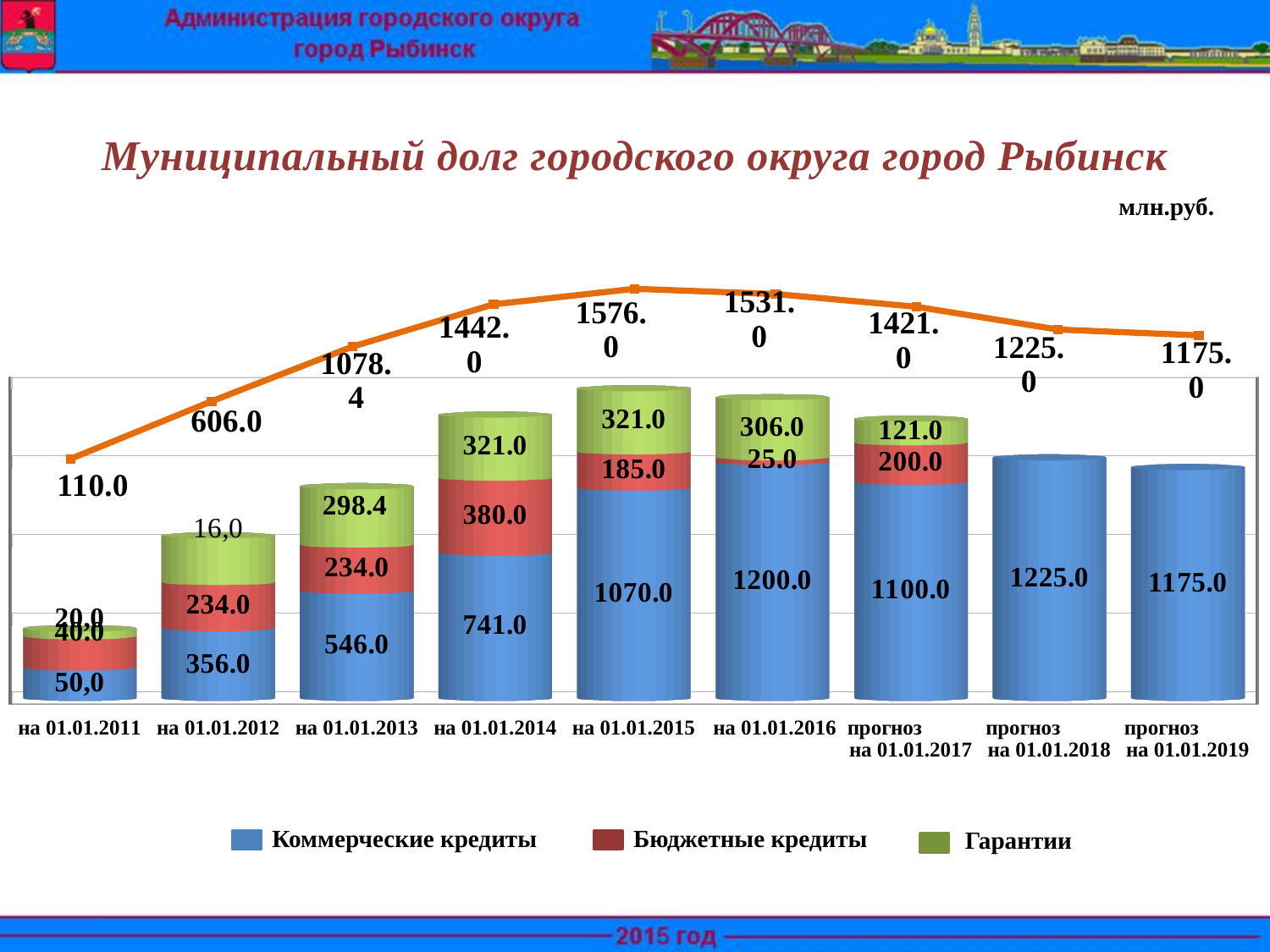
What is the value of Бюджетные кредиты for на 01.01.2015? 185.0 Which is larger: Бюджетные кредиты for на 01.01.2014 or for прогноз на 01.01.2017? на 01.01.2014 At which date is the total municipal debt lowest? на 01.01.2011 At which date is the total municipal debt highest? на 01.01.2015 How many dates (categories) are shown on the x axis? 9 What is the value of Коммерческие кредиты for на 01.01.2014? 741.0 What kind of chart is this? Stacked bar chart with a line What is the difference between the Коммерческие кредиты values for прогноз на 01.01.2018 and прогноз на 01.01.2019? 50.0 What is the total municipal debt shown for на 01.01.2016? 1531.0 What is the value of Гарантии for на 01.01.2013? 298.4 How many series does the legend list? 3 Does the total municipal debt rise or fall from на 01.01.2015 to прогноз на 01.01.2019? Fall